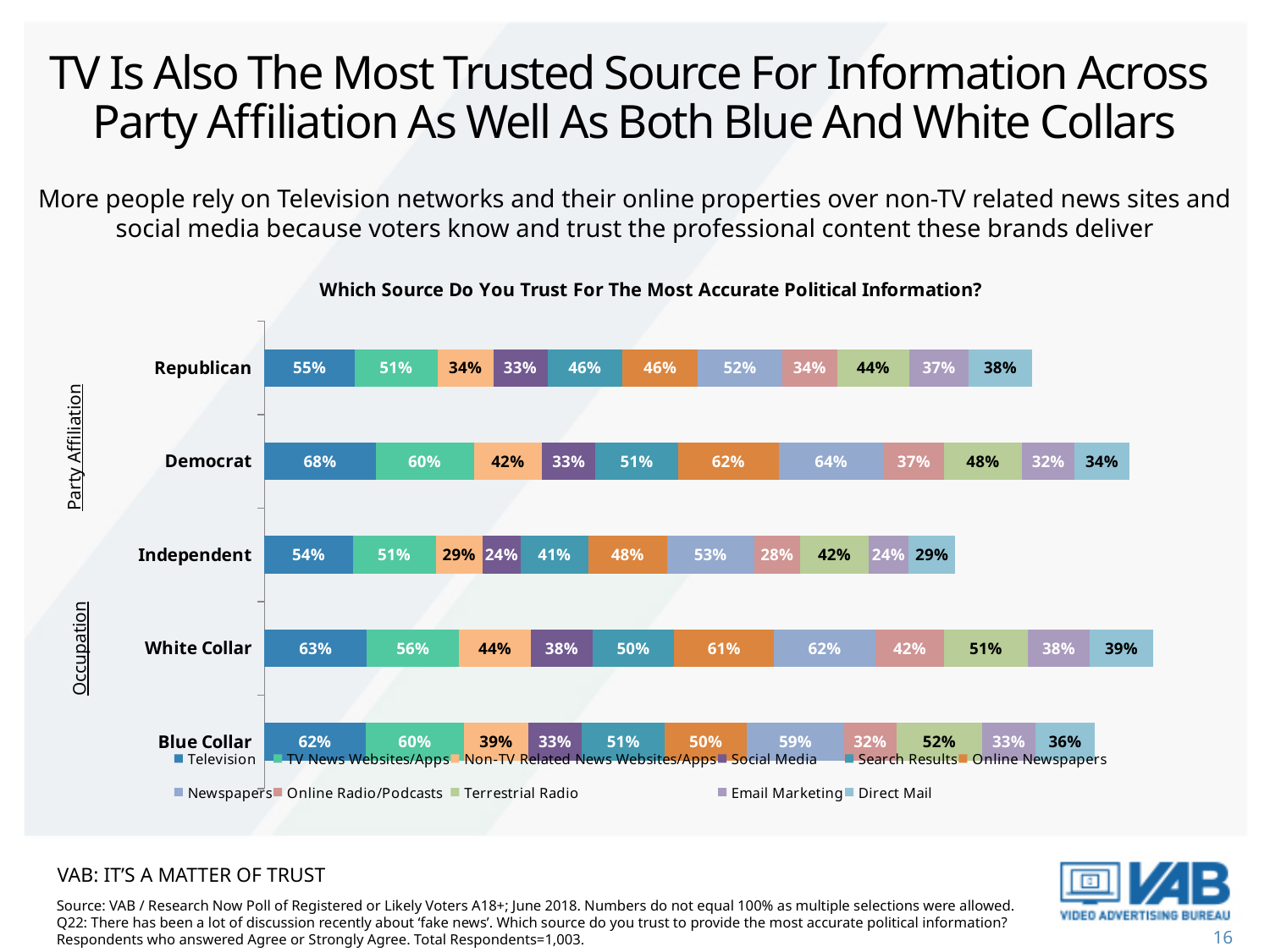
What is the Independent value for Social Media? 24% Which is larger for White Collar: Online Newspapers or Newspapers? Newspapers Which source has the highest value among Democrats? Television Which group has the lowest value for Television? Independent What is the Blue Collar value for Terrestrial Radio? 52% How many sources does the legend list? 11 What is the difference between the Democrat and Republican values for Television? 13% How many groups (bars) are shown in the chart? 5 What is the title of the chart? Which Source Do You Trust For The Most Accurate Political Information? What percentage of Republicans trust Television for the most accurate political information? 55% What is the Democrat value for Online Newspapers? 62% What type of chart is shown on the slide? Stacked bar chart